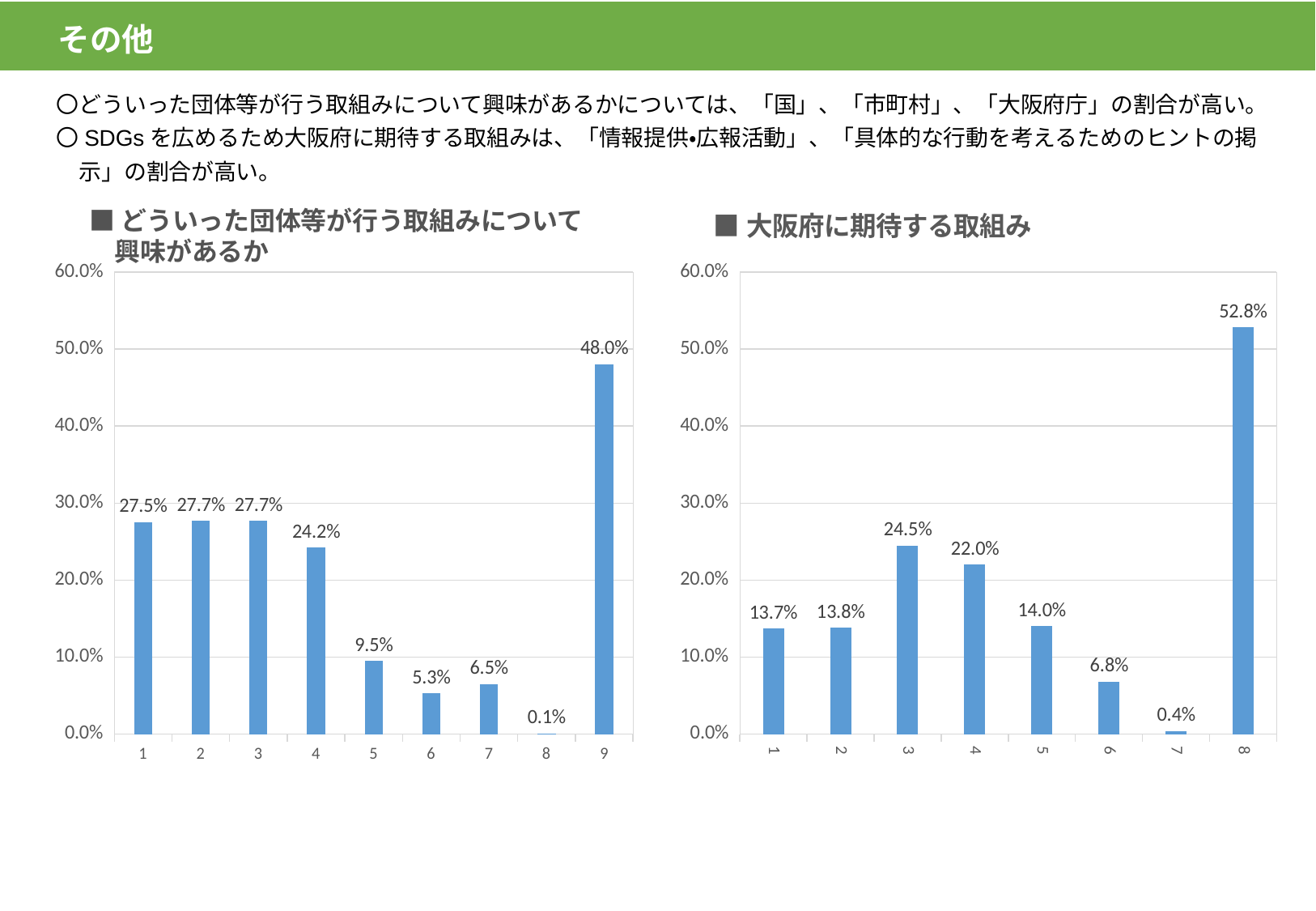
In the left chart (どういった団体等が行う取組みについて興味があるか), what is the value for category 9? 48.0% In the right chart (大阪府に期待する取組み), what is the value for category 8? 52.8% In the right chart (大阪府に期待する取組み), which category has the highest value? 8 What kind of chart is the right chart (大阪府に期待する取組み)? Bar chart In the right chart (大阪府に期待する取組み), what is the value for category 3? 24.5% In the right chart (大阪府に期待する取組み), how many categories are plotted? 8 In the left chart (どういった団体等が行う取組みについて興味があるか), how many categories are plotted? 9 In the left chart (どういった団体等が行う取組みについて興味があるか), which is larger, the value for category 6 or category 7? 7 In the left chart (どういった団体等が行う取組みについて興味があるか), what is the difference between the values for category 4 and category 5? 14.7% In the right chart (大阪府に期待する取組み), what is the difference between the values for category 8 and category 3? 28.3% In the left chart (どういった団体等が行う取組みについて興味があるか), which category has the lowest value? 8 In the left chart (どういった団体等が行う取組みについて興味があるか), what is the value for category 5? 9.5%